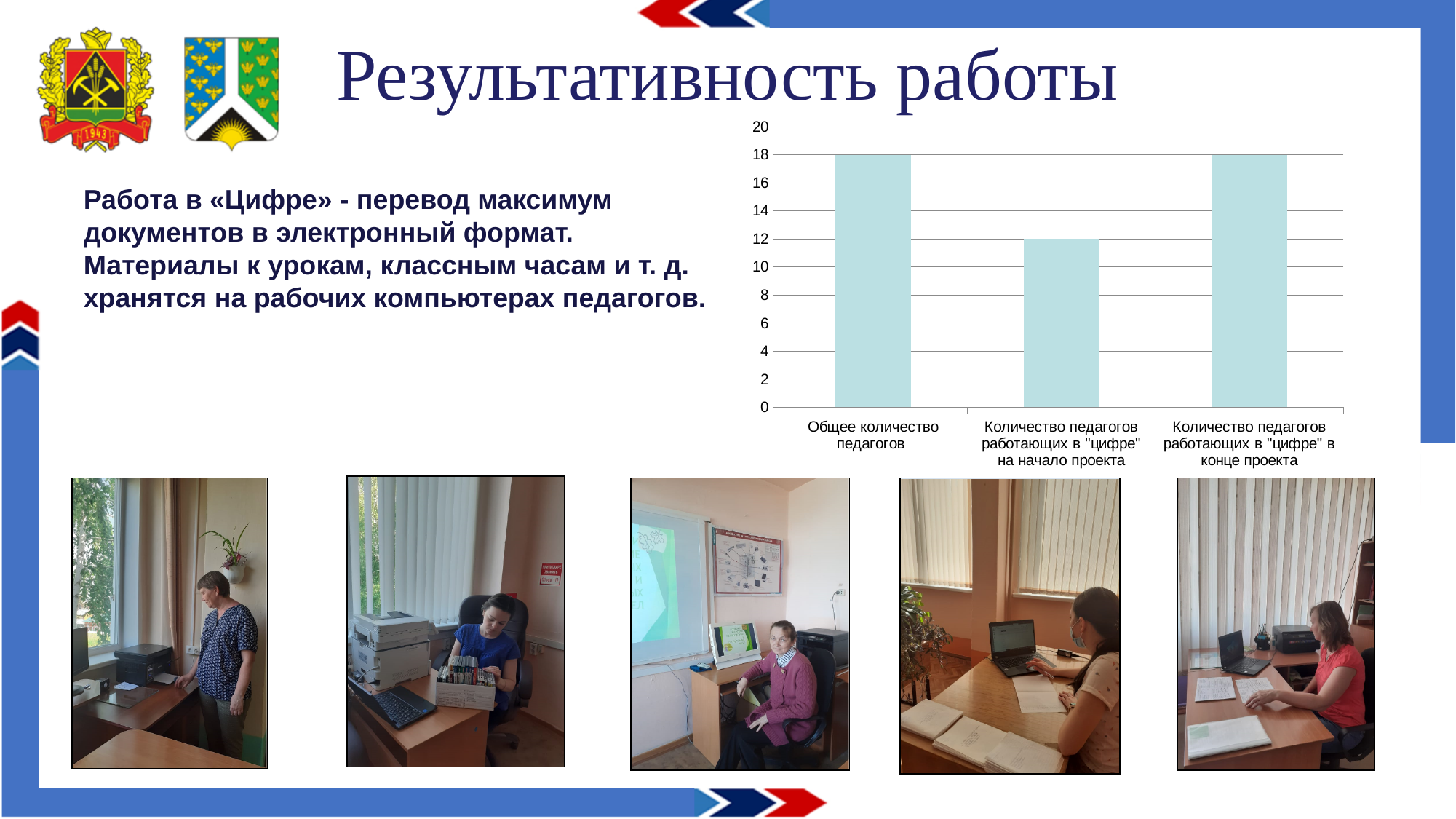
What is the maximum value shown on the vertical axis of the chart? 20 Is the value for "Количество педагогов работающих в "цифре" на начало проекта" greater or less than 10? greater Which category has the lowest value? Количество педагогов работающих в "цифре" на начало проекта What kind of chart is shown on the slide? bar chart What is the value for "Общее количество педагогов"? 18 Does the value rise or fall from the second category to the third category? rise What is the value for "Количество педагогов работающих в "цифре" в конце проекта"? 18 What is the value for "Количество педагогов работающих в "цифре" на начало проекта"? 12 Is the value for "Общее количество педагогов" greater or less than 20? less How many categories are shown on the chart? 3 What is the difference between the number of teachers working in "цифра" at the end of the project and at the start of the project? 6 Which is larger: the value for "Общее количество педагогов" or the value for "Количество педагогов работающих в "цифре" на начало проекта"? Общее количество педагогов